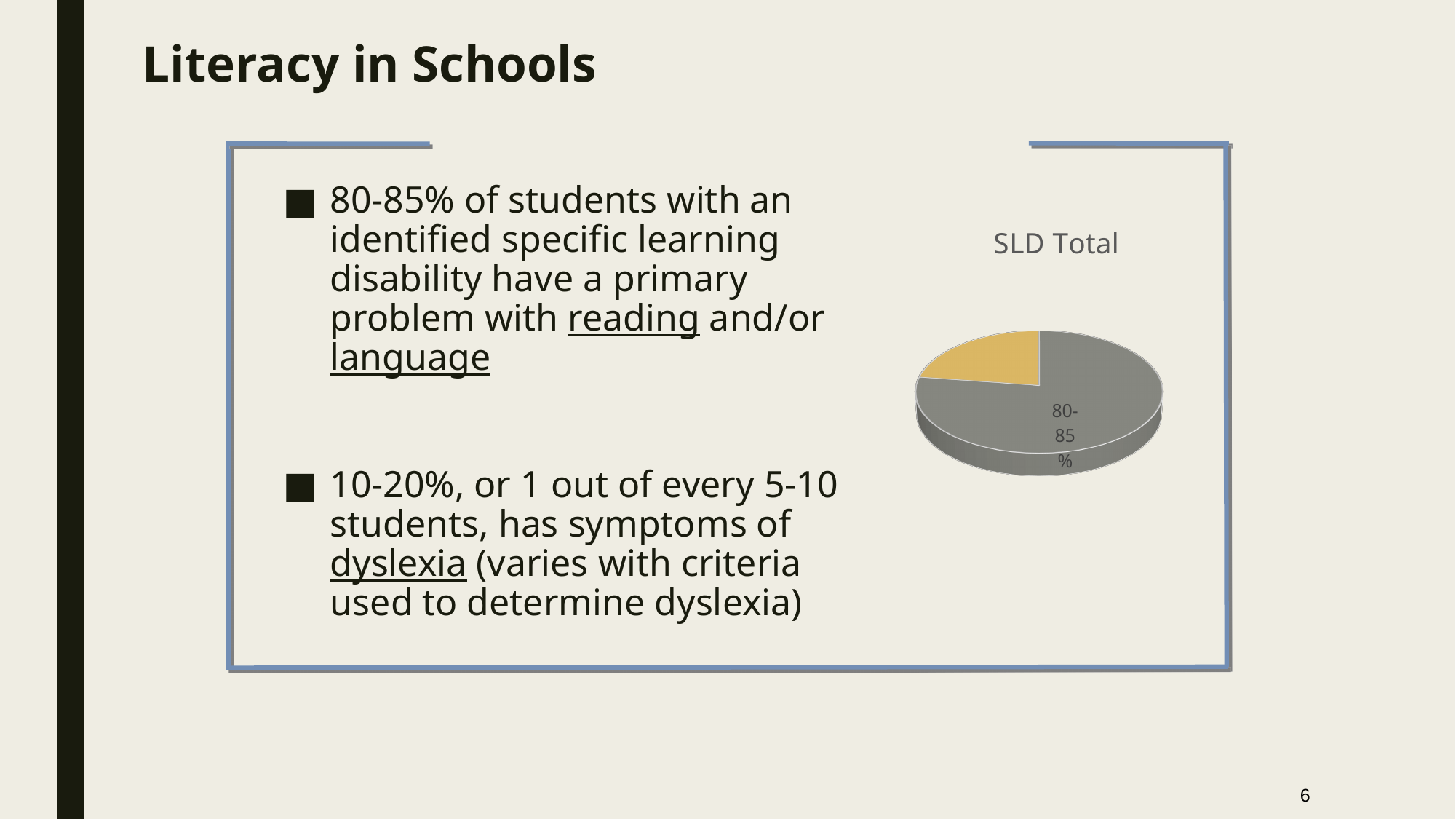
What value is printed on the large gray slice of the pie chart? 80-85% What colour is the slice labelled 80-85%? Gray What kind of chart is shown on the slide? Pie chart What is the title of the chart? SLD Total What share of the pie does the gray slice represent, according to its label? 80-85% How many slices does the pie chart have? 2 Is the gray slice of the pie chart larger or smaller than the gold slice? Larger Which slice of the pie chart is the smallest, the gray one or the gold one? The gold one Does the gold slice take up more or less than half of the pie? Less Which slice of the pie chart is the largest, the gray one or the gold one? The gray one